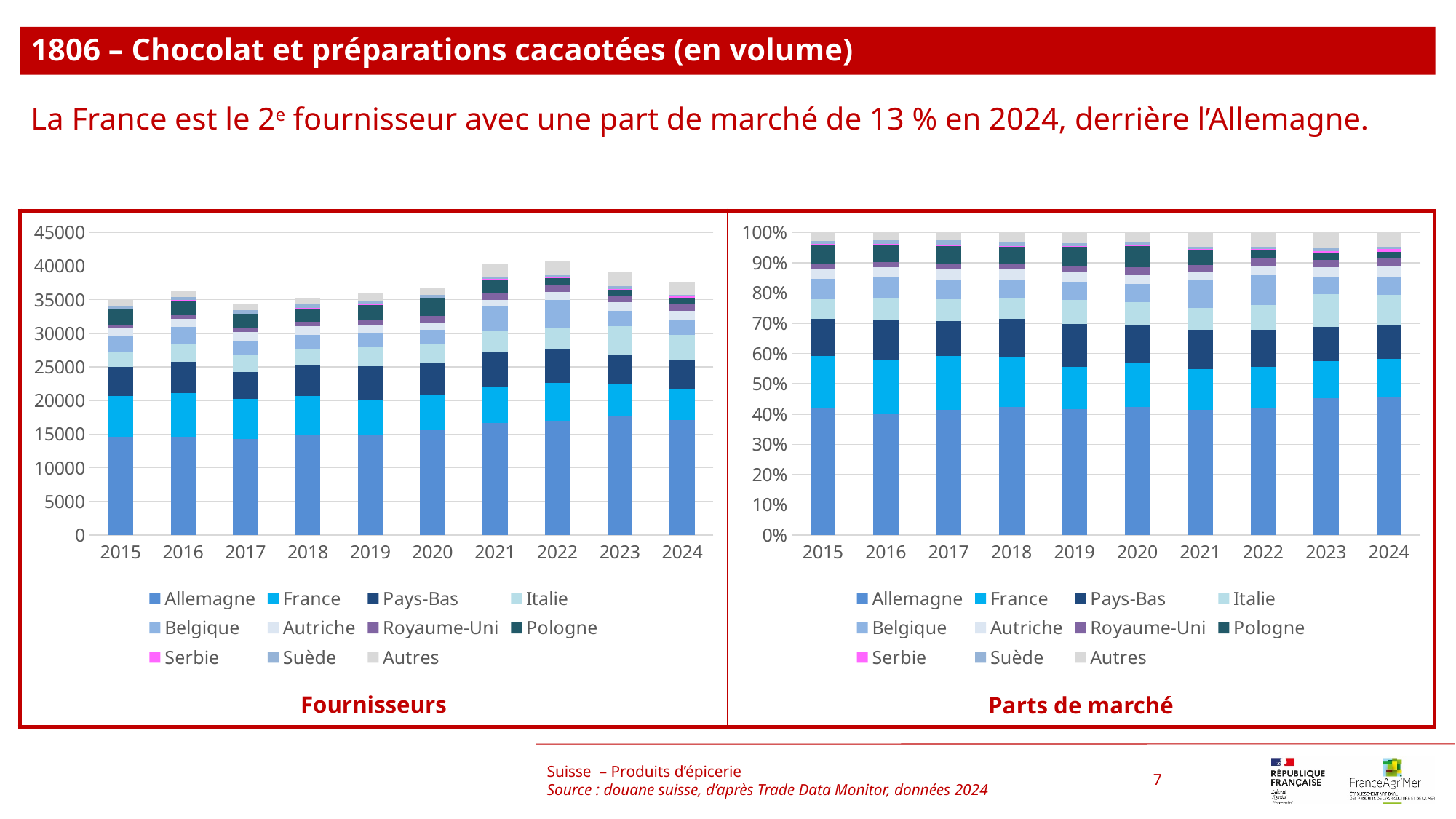
In the 'Fournisseurs' chart, is the Allemagne value for 2023 greater or less than 15000? greater In the 'Fournisseurs' chart, which is larger, the total stacked value for 2021 or for 2017? 2021 Which series is listed first in the legend of the 'Fournisseurs' chart? Allemagne In the 'Fournisseurs' chart, is the total stacked value for 2024 greater or less than 40000? less How many series does the legend of the 'Parts de marché' chart list? 11 What is the title shown below the right-hand chart? Parts de marché In the 'Fournisseurs' chart, how many years are shown on the x axis? 10 In the 'Parts de marché' chart, is the Allemagne share for 2018 greater or less than 50%? less What kind of chart is the 'Fournisseurs' chart on the left? Stacked bar chart What kind of chart is the 'Parts de marché' chart on the right? 100% stacked bar chart